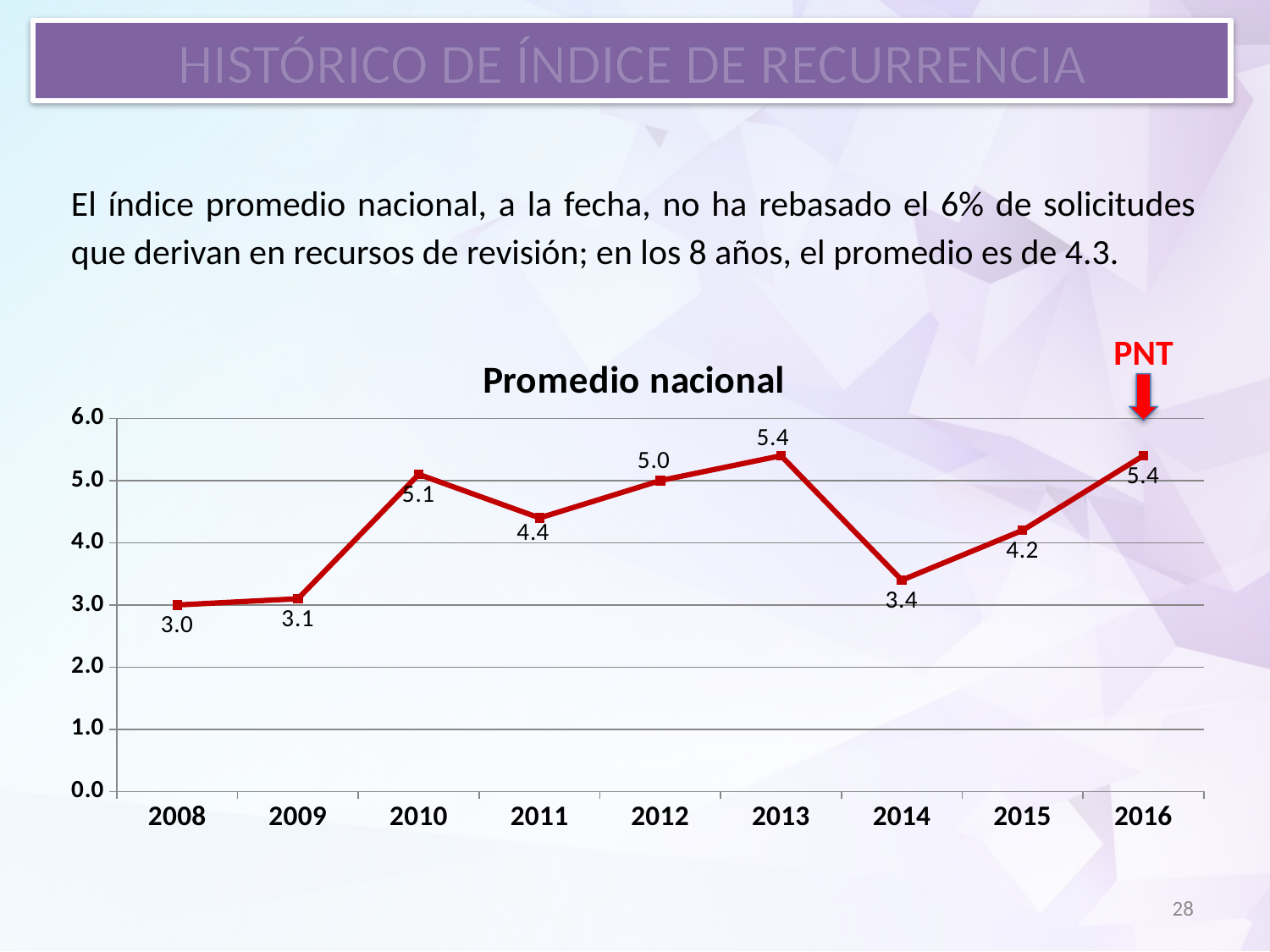
What is the value for 2010? 5.1 Is the value for 2015 greater or less than 4.0? greater What is the title of the chart? Promedio nacional Does the value rise or fall from 2008 to 2010? rise What kind of chart is shown? line chart What is the value for 2008? 3.0 How many years are plotted on the x axis? 9 Which is larger, the value for 2011 or the value for 2012? 2012 What is the value for 2014? 3.4 Which year has the lowest value? 2008 What label is shown with the red arrow pointing at the 2016 point? PNT What is the difference between the values for 2013 and 2014? 2.0